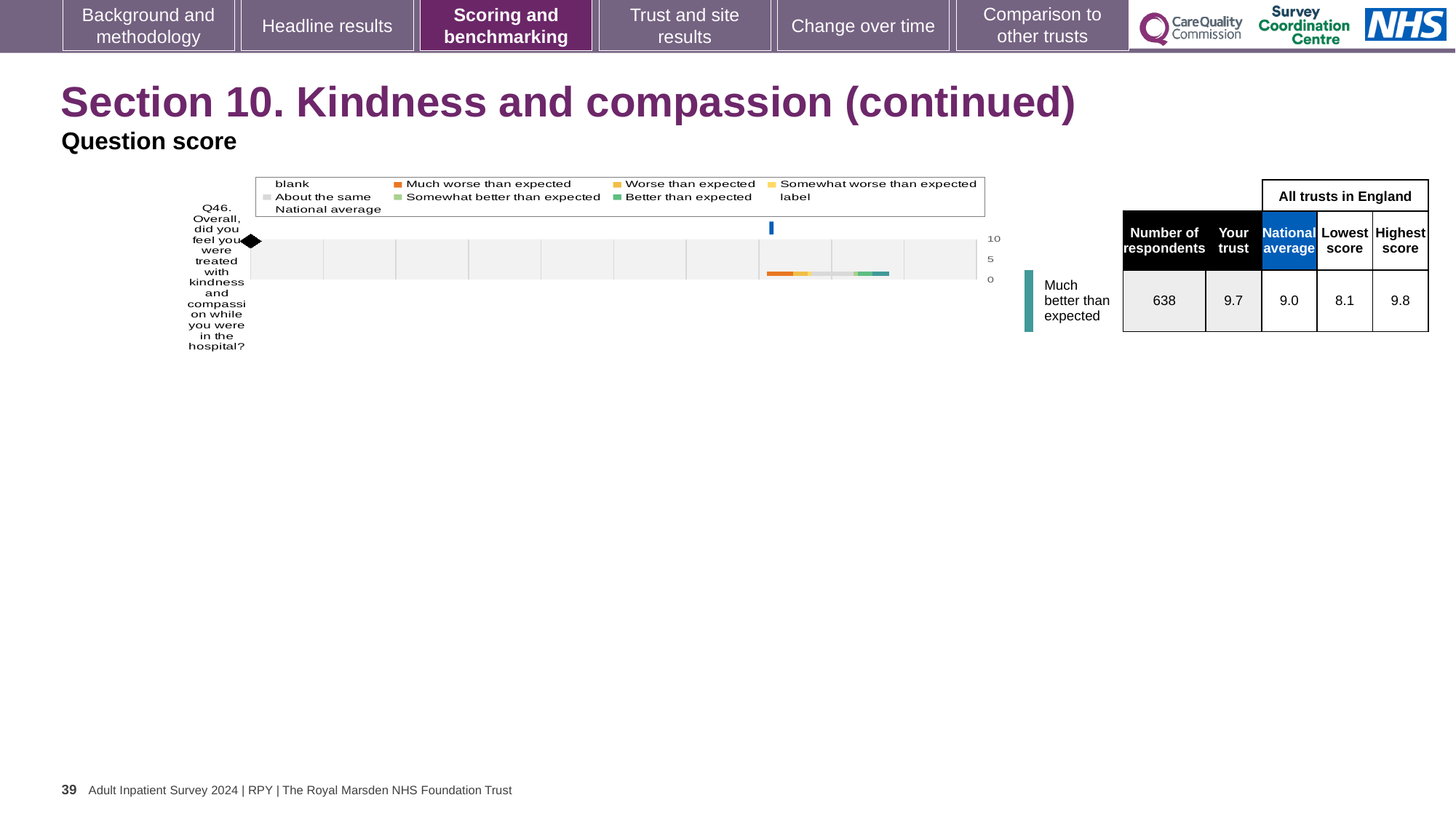
What kind of chart is shown on the slide for Q46? bar chart What is the highest score among all trusts in England for Q46? 9.8 What is the difference between the 'Your trust' score and the national average for Q46? 0.7 What is the highest value shown on the chart's axis? 10 What is the national average score for Q46 shown next to the chart? 9.0 What is the lowest score among all trusts in England for Q46? 8.1 How many questions (categories) are plotted on the chart? 1 How many entries does the chart's legend list? 9 What is the number of respondents for Q46? 638 Which is larger for Q46, the 'Your trust' score or the national average? Your trust Which question is plotted on the chart? Q46. Overall, did you feel you were treated with kindness and compassion while you were in the hospital? What is the 'Your trust' score for Q46 shown next to the chart? 9.7